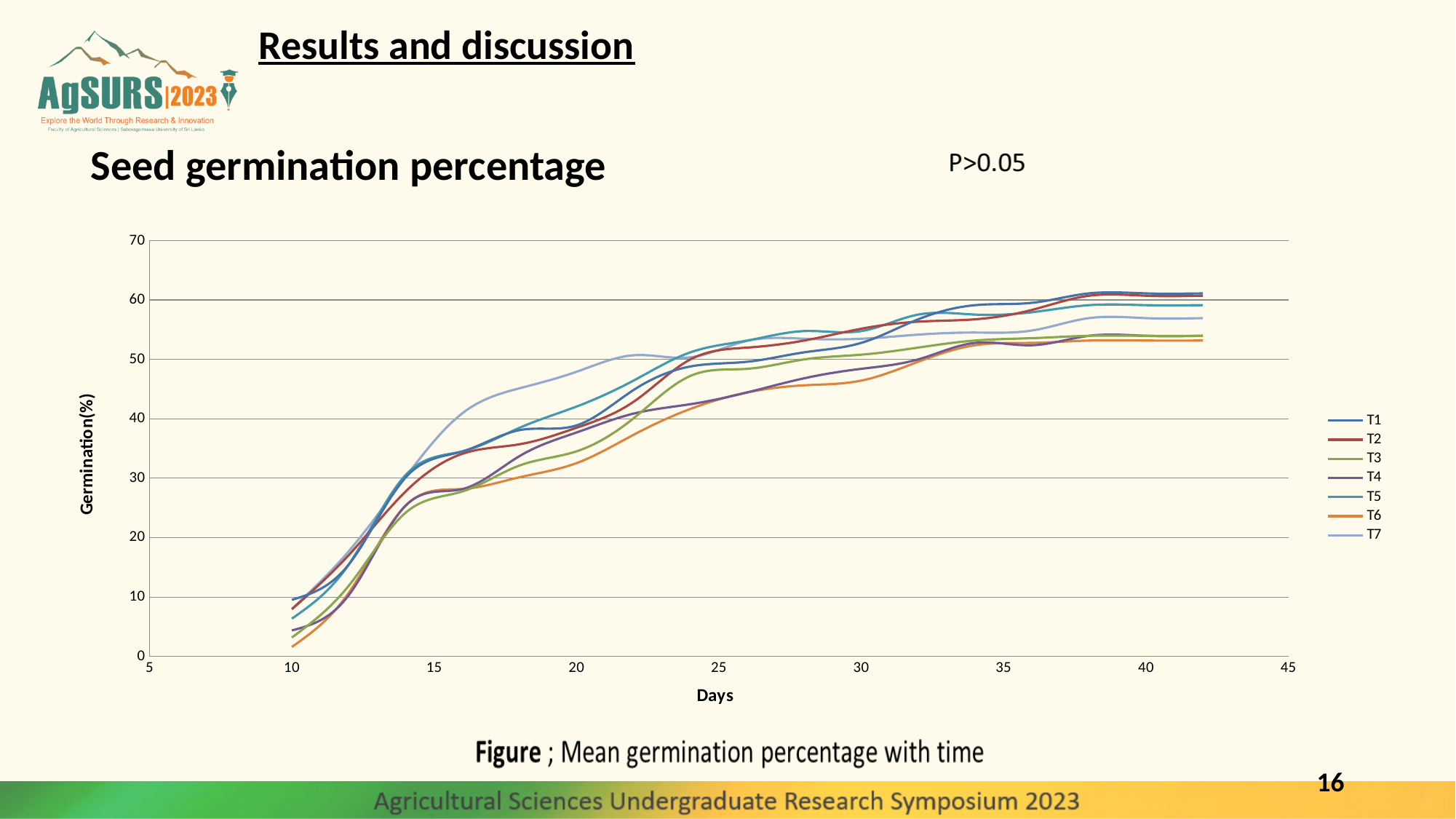
Is the value for T7 at day 15 greater or less than 30? greater What is the title of the horizontal axis? Days How many series does the legend list? 7 Is the value for T6 at day 30 greater or less than 50? less What kind of chart is shown on the slide? line chart What is the title of the vertical axis? Germination(%) Is the value for T6 at day 10 greater or less than 10? less At day 20, which series has the larger value, T7 or T6? T7 Do the germination percentage values rise or fall as the days increase? rise At day 10, which series has the larger value, T1 or T6? T1